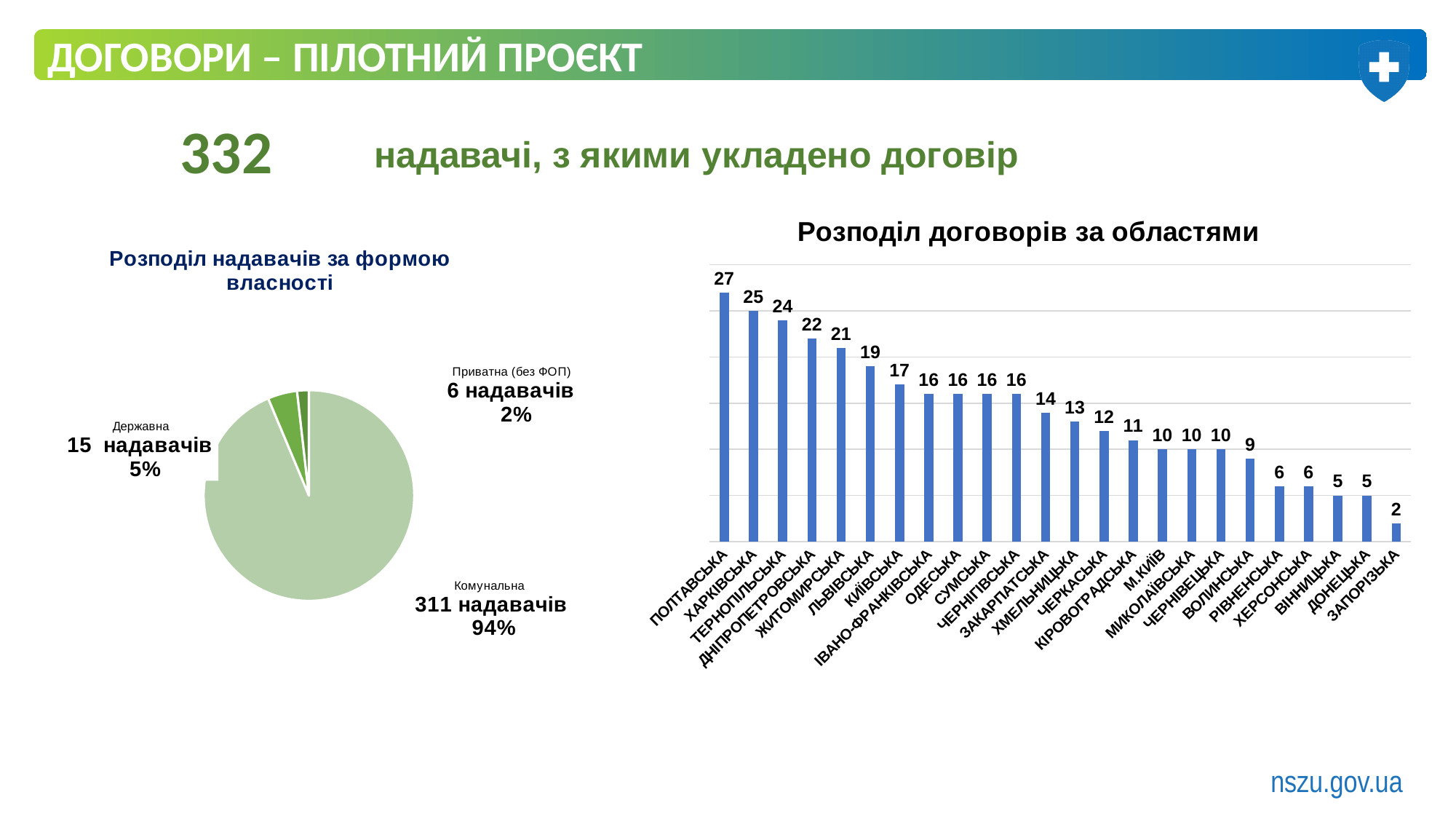
In the pie chart 'Розподіл надавачів за формою власності', how many providers are Державна? 15 In the chart 'Розподіл договорів за областями', which region has the lowest value? ЗАПОРІЗЬКА In the chart 'Розподіл договорів за областями', which region has the highest value? ПОЛТАВСЬКА In the chart 'Розподіл договорів за областями', how many contracts does ПОЛТАВСЬКА have? 27 In the chart 'Розподіл договорів за областями', what is the difference between ХАРКІВСЬКА and ЛЬВІВСЬКА? 6 In the chart 'Розподіл договорів за областями', what is the value for ЗАКАРПАТСЬКА? 14 In the pie chart 'Розподіл надавачів за формою власності', what share does Комунальна have? 94% How many slices does the pie chart 'Розподіл надавачів за формою власності' have? 3 What kind of chart is 'Розподіл договорів за областями'? bar chart In the chart 'Розподіл договорів за областями', do the values rise or fall from left to right? fall How many regions are shown in the chart 'Розподіл договорів за областями'? 24 In the chart 'Розподіл договорів за областями', which has a larger value, ЖИТОМИРСЬКА or ЧЕРКАСЬКА? ЖИТОМИРСЬКА